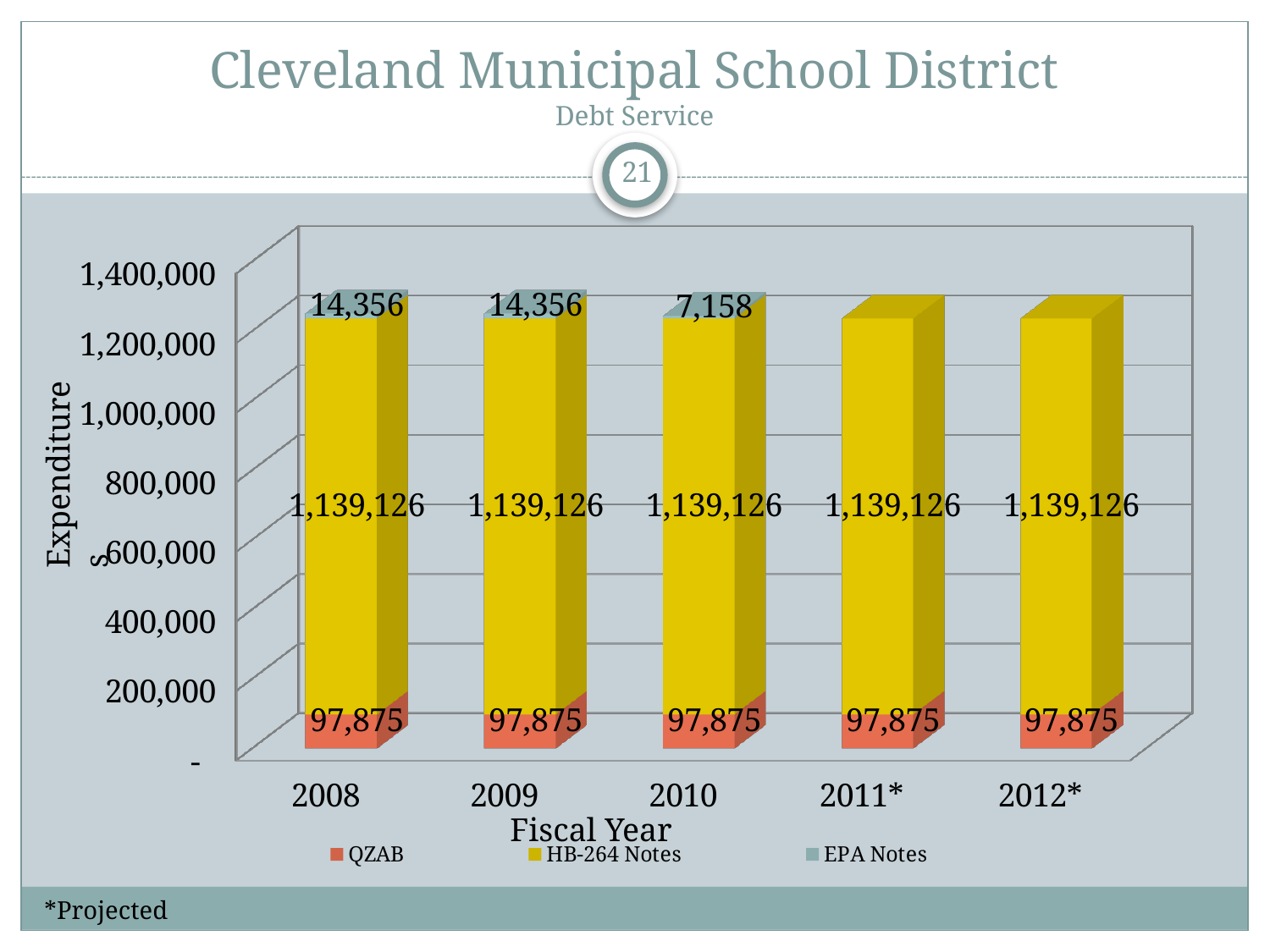
Which fiscal year has the lowest labelled EPA Notes value? 2010 Which is larger in 2008, the QZAB value or the EPA Notes value? QZAB How many series does the legend list? 3 What is the value of EPA Notes for fiscal year 2008? 14,356 What is the total of the stacked bar for fiscal year 2008? 1,251,357 What is the value of EPA Notes for fiscal year 2010? 7,158 What is the value of QZAB for fiscal year 2012*? 97,875 What is the value of HB-264 Notes for fiscal year 2009? 1,139,126 How many fiscal years are shown on the x axis? 5 What kind of chart is shown on the slide? Stacked bar chart What is the total of the stacked bar for fiscal year 2011*? 1,237,001 What is the difference between the EPA Notes value in 2009 and in 2010? 7,198